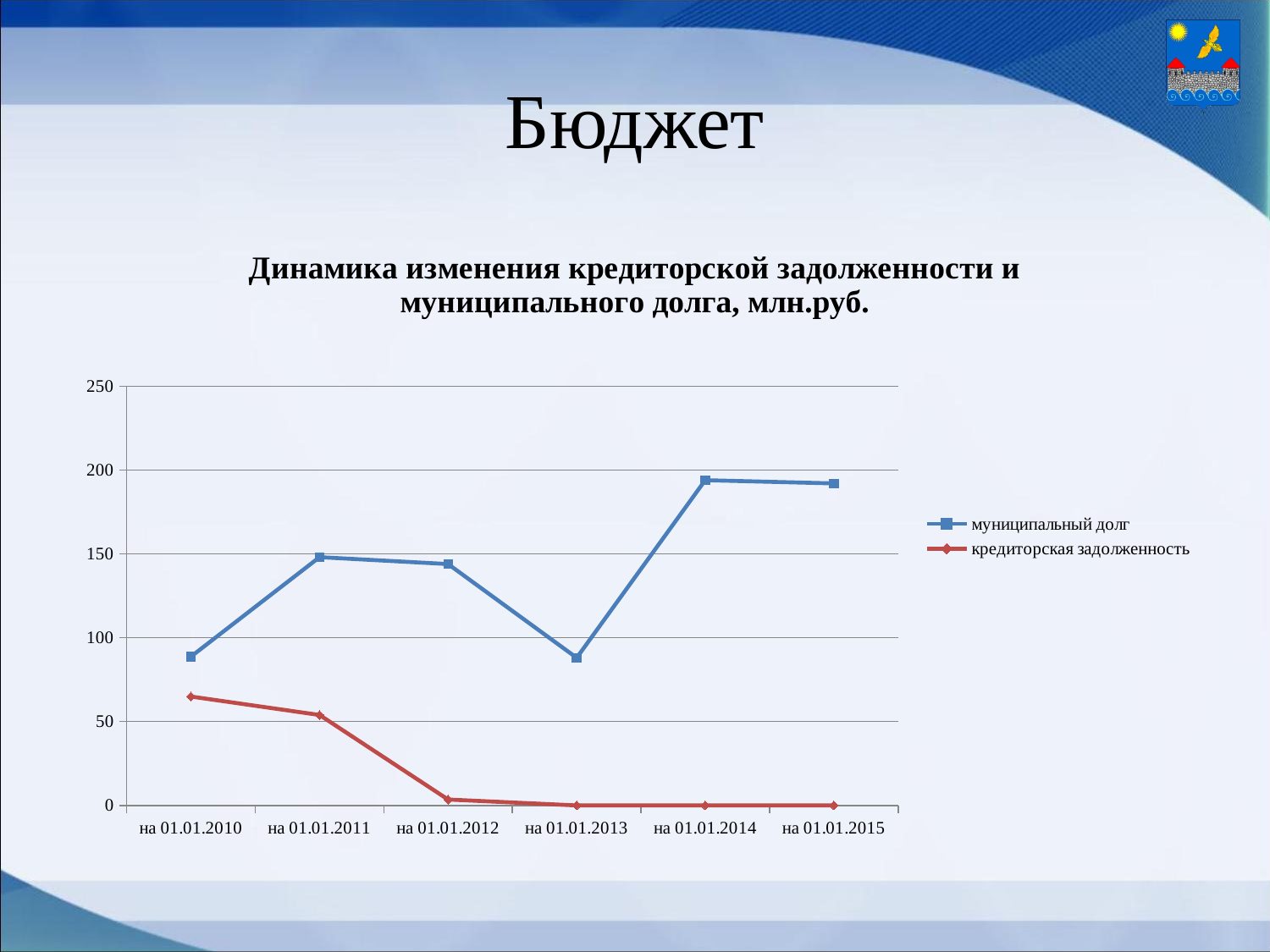
Is the value for муниципальный долг на 01.01.2010 greater or less than 100? less How many dates are shown along the x axis? 6 Is the value for муниципальный долг на 01.01.2014 greater or less than 150? greater How many series does the legend list? 2 Which colour is used for the муниципальный долг series? blue Which is larger for муниципальный долг: the value на 01.01.2011 or на 01.01.2013? на 01.01.2011 On which date is кредиторская задолженность highest? на 01.01.2010 На 01.01.2010, which series has the larger value: муниципальный долг or кредиторская задолженность? муниципальный долг Is the value for кредиторская задолженность на 01.01.2010 greater or less than 50? greater What kind of chart is shown on the slide? line chart Does кредиторская задолженность rise or fall from 01.01.2010 to 01.01.2015? fall